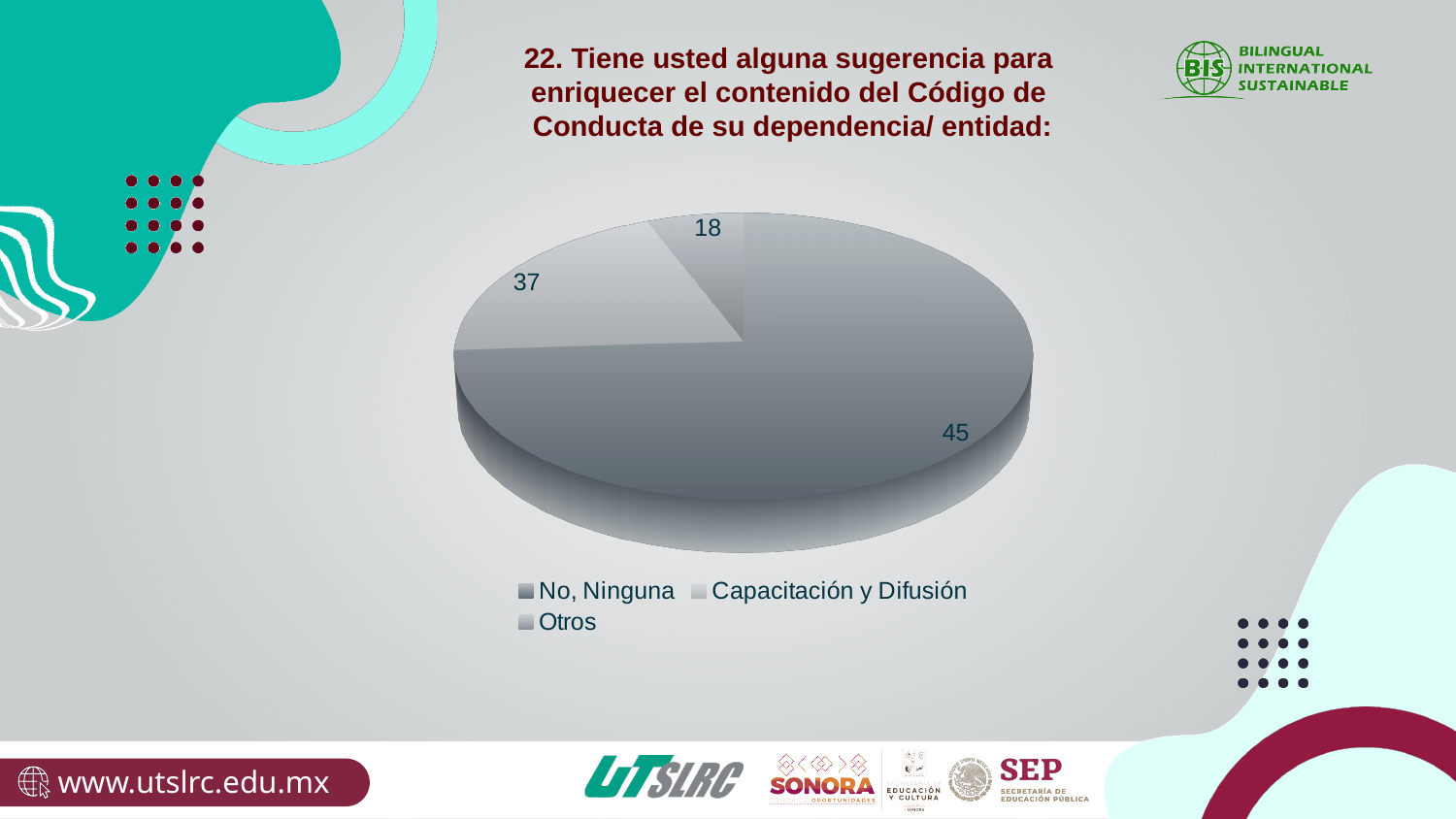
What is the value for 'Otros' in the pie chart? 18 What kind of chart is shown on the slide? pie chart How many slices does the pie chart have? 3 How many entries does the legend of the pie chart list? 3 What is the value for 'No, Ninguna' in the pie chart? 45 What is the value of the smallest slice in the pie chart? 18 What is the difference between the largest slice (45) and the smallest slice (18)? 27 What is the value of the largest slice in the pie chart? 45 Which is larger in the pie chart, 'No, Ninguna' or 'Capacitación y Difusión'? No, Ninguna What is the total of all the slice values in the pie chart? 100 What is the value for 'Capacitación y Difusión' in the pie chart? 37